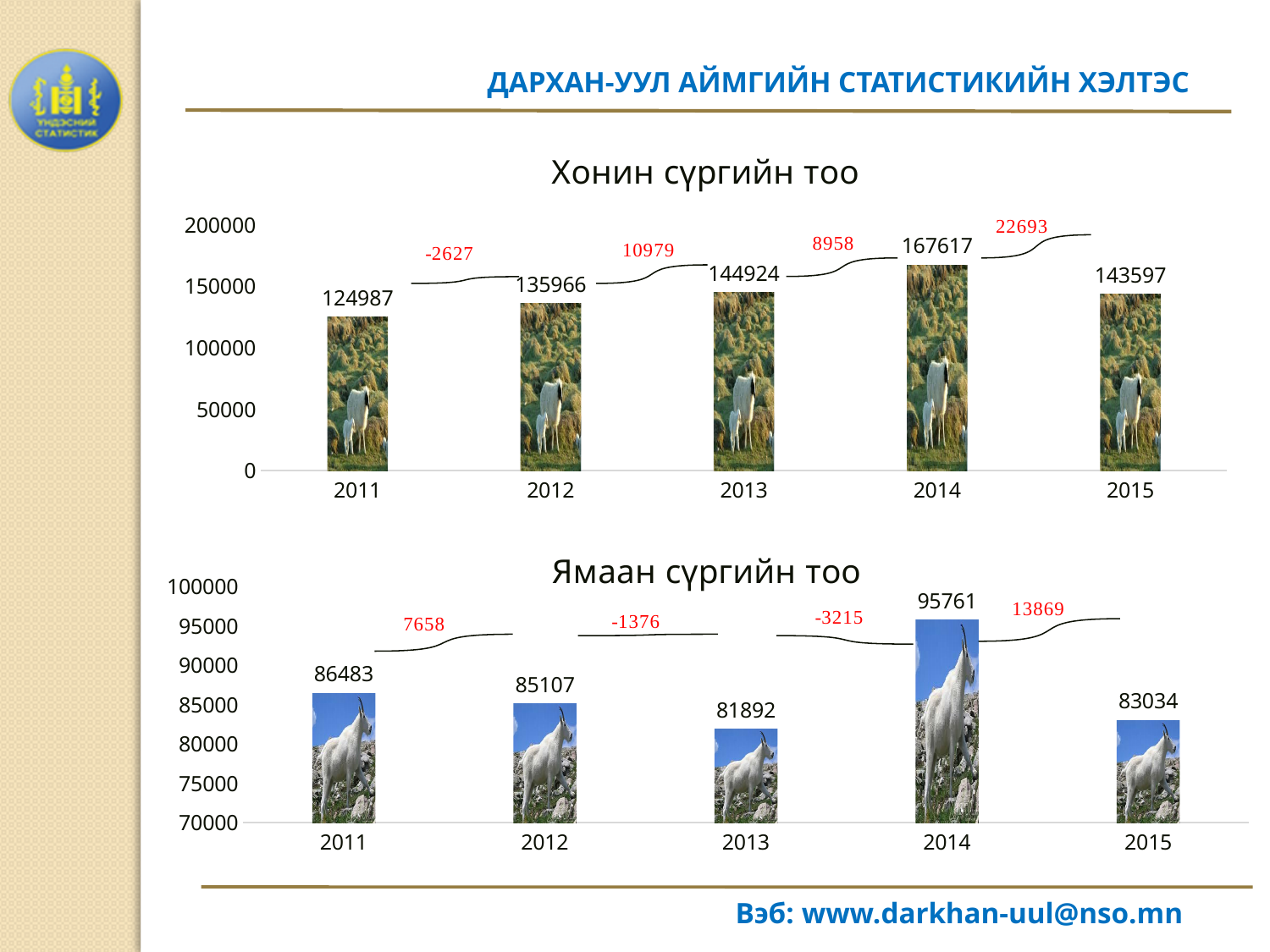
What kind of chart is the lower chart titled "Ямаан сүргийн тоо"? bar chart In the chart titled "Хонин сүргийн тоо", what is the difference between the 2014 value and the 2015 value? 24020 In the chart titled "Ямаан сүргийн тоо", which year has the highest value? 2014 In the chart titled "Хонин сүргийн тоо", is the value for 2013 greater or less than 150000? less In the chart titled "Ямаан сүргийн тоо", which year has the lowest value? 2013 In the chart titled "Хонин сүргийн тоо", how many years are shown on the x axis? 5 In the chart titled "Ямаан сүргийн тоо", which is larger, the value for 2011 or the value for 2015? 2011 In the chart titled "Хонин сүргийн тоо", what is the value for 2014? 167617 In the chart titled "Ямаан сүргийн тоо", what is the difference between the 2011 value and the 2012 value? 1376 In the chart titled "Хонин сүргийн тоо", which year has the highest value? 2014 In the chart titled "Хонин сүргийн тоо", which year has the lowest value? 2011 In the chart titled "Ямаан сүргийн тоо", what is the value for 2013? 81892